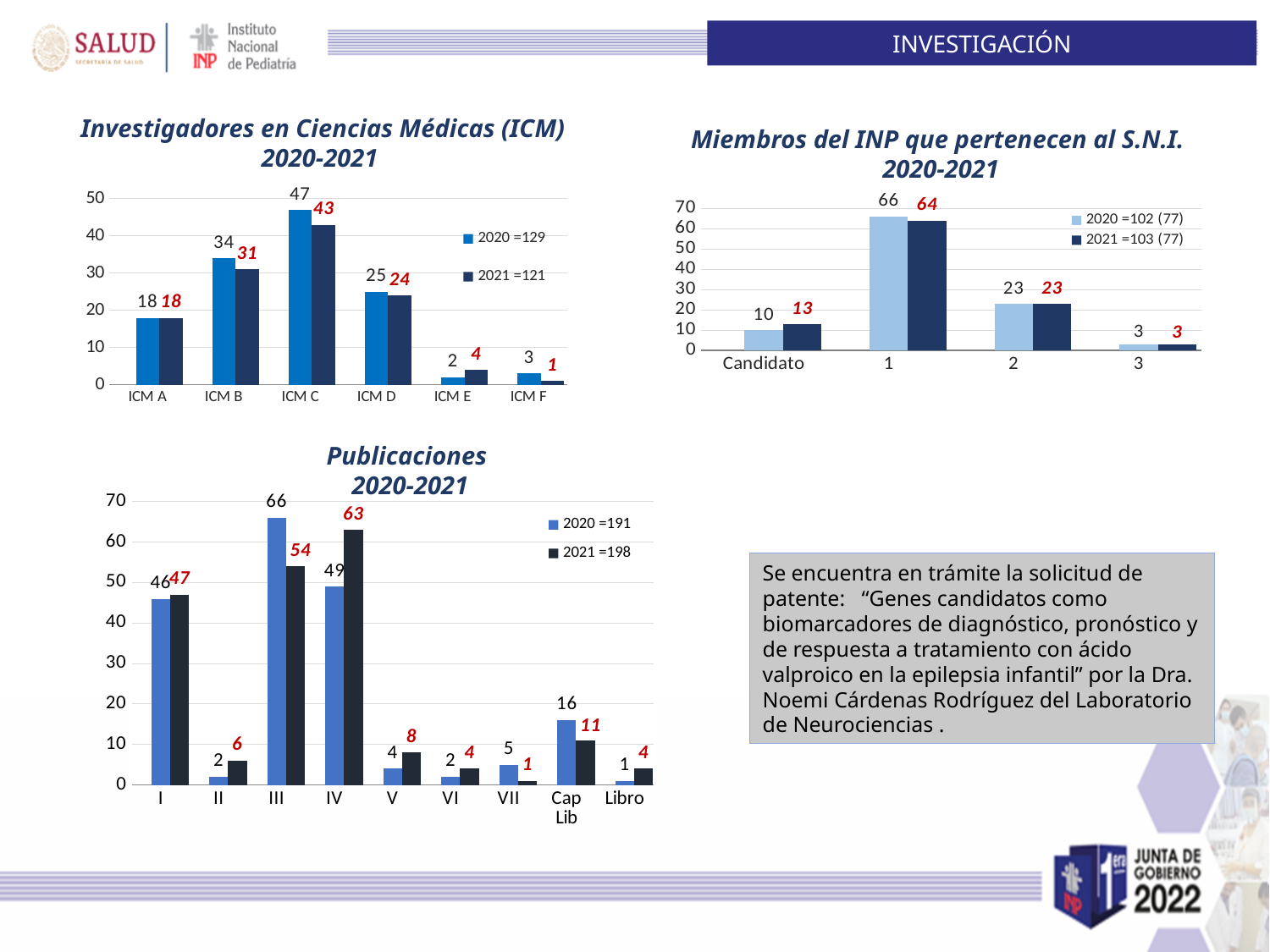
In the 'Investigadores en Ciencias Médicas (ICM) 2020-2021' chart, how many categories are shown on the x axis? 6 In the 'Investigadores en Ciencias Médicas (ICM) 2020-2021' chart, what is the difference between the 2020 and 2021 values for ICM B? 3 In the 'Investigadores en Ciencias Médicas (ICM) 2020-2021' chart, what is the 2020 value for ICM C? 47 In the 'Miembros del INP que pertenecen al S.N.I. 2020-2021' chart, what is the 2021 value for Candidato? 13 In the 'Publicaciones 2020-2021' chart, which category has the highest 2020 value? III In the 'Miembros del INP que pertenecen al S.N.I. 2020-2021' chart, which category has the lowest 2020 value? 3 What kind of chart is the 'Publicaciones 2020-2021' chart? bar chart In the 'Publicaciones 2020-2021' chart, what is the 2021 value for IV? 63 In the 'Miembros del INP que pertenecen al S.N.I. 2020-2021' chart, is the 2020 value for category 1 larger or smaller than the 2021 value? larger In the 'Publicaciones 2020-2021' chart, what is the difference between the 2020 and 2021 values for Cap Lib? 5 In the 'Miembros del INP que pertenecen al S.N.I. 2020-2021' chart, how many series does the legend list? 2 In the 'Investigadores en Ciencias Médicas (ICM) 2020-2021' chart, which category has the highest 2021 value? ICM C